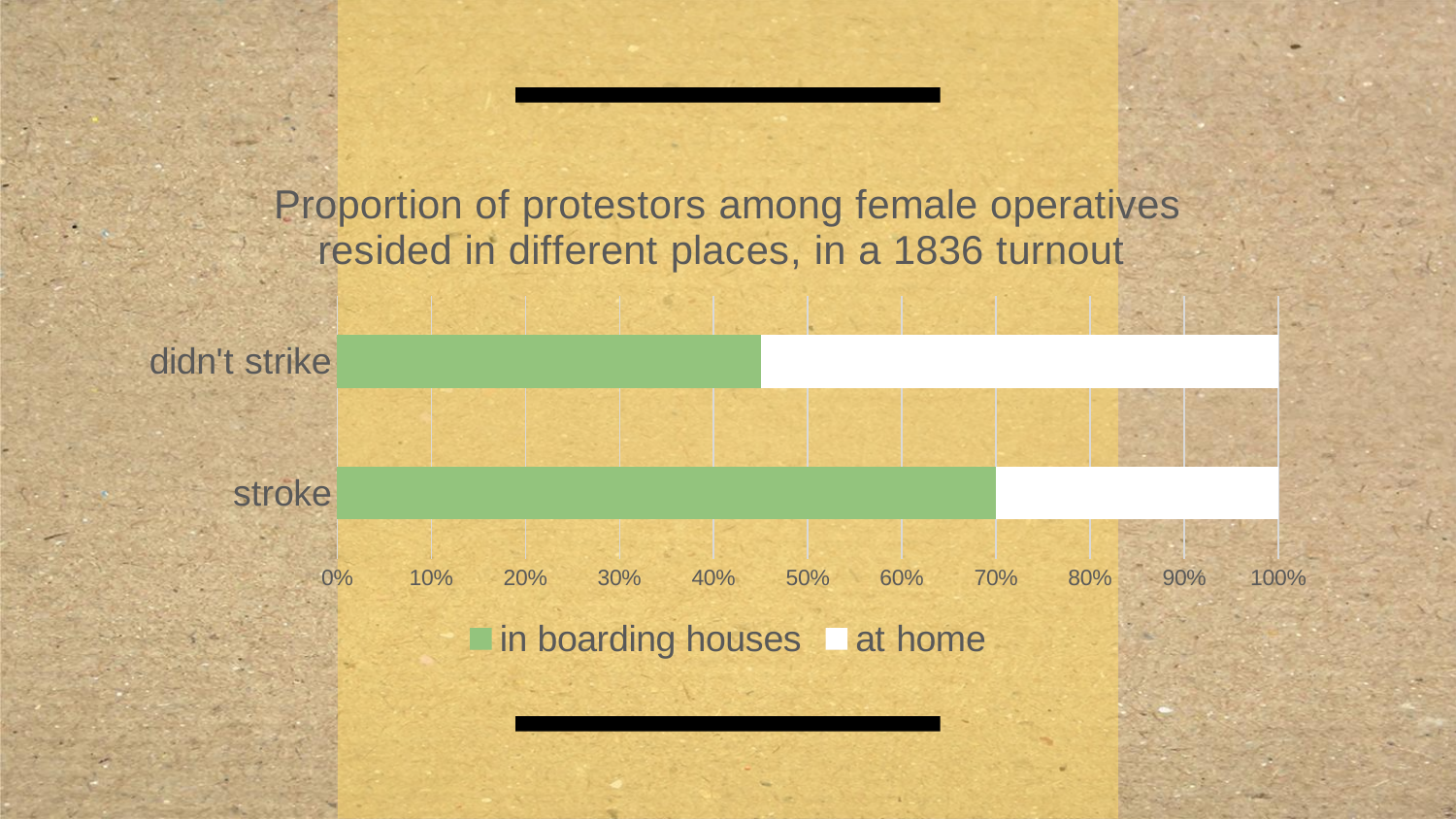
Is the 'at home' value for 'didn't strike' greater or less than 50%? greater What is the title of the chart? Proportion of protestors among female operatives resided in different places, in a 1836 turnout How many series does the legend list? 2 Which category has the larger share of operatives in boarding houses? stroke What is the total of the stacked bar for 'stroke'? 100% Which category has the larger share of operatives at home? didn't strike What kind of chart is shown on the slide? bar chart Which colour represents the 'in boarding houses' series? green Is the 'in boarding houses' value for 'didn't strike' greater or less than 50%? less How many categories are plotted on the chart? 2 Is the 'in boarding houses' value for 'stroke' greater or less than 60%? greater